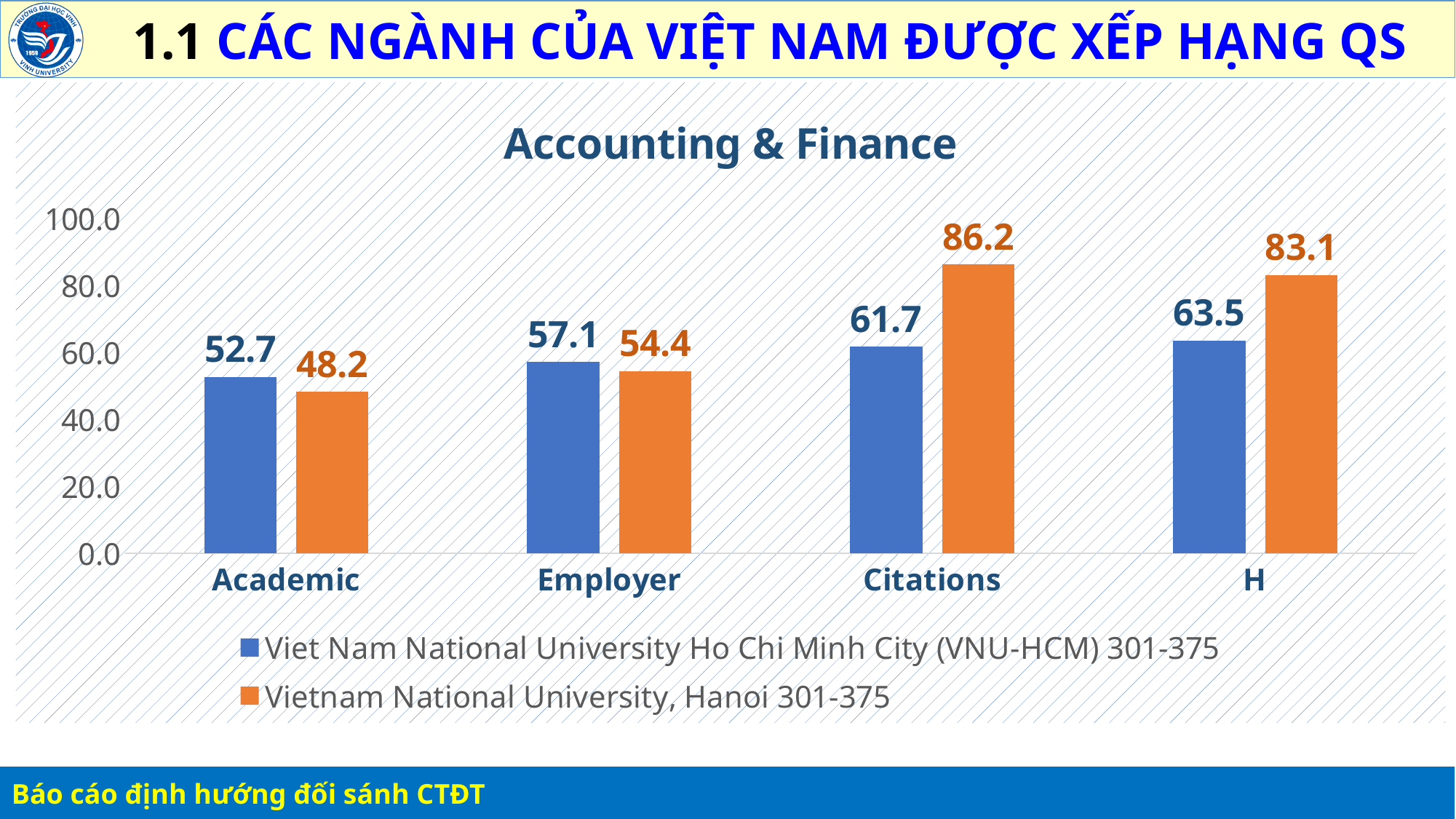
What is the value for Citations for Vietnam National University, Hanoi? 86.2 What is the value for Academic for Viet Nam National University Ho Chi Minh City (VNU-HCM)? 52.7 What is the value for H for Vietnam National University, Hanoi? 83.1 Is the value for H for Viet Nam National University Ho Chi Minh City (VNU-HCM) greater or less than 60.0? greater For Employer, which university has the larger value? Viet Nam National University Ho Chi Minh City (VNU-HCM) Which category has the lowest value for Vietnam National University, Hanoi? Academic What kind of chart is shown? Bar chart What is the difference between the Citations values for Vietnam National University, Hanoi and Viet Nam National University Ho Chi Minh City (VNU-HCM)? 24.5 Which category has the highest value for Viet Nam National University Ho Chi Minh City (VNU-HCM)? H What is the title of the chart? Accounting & Finance How many series does the legend list? 2 How many categories are shown on the x axis? 4